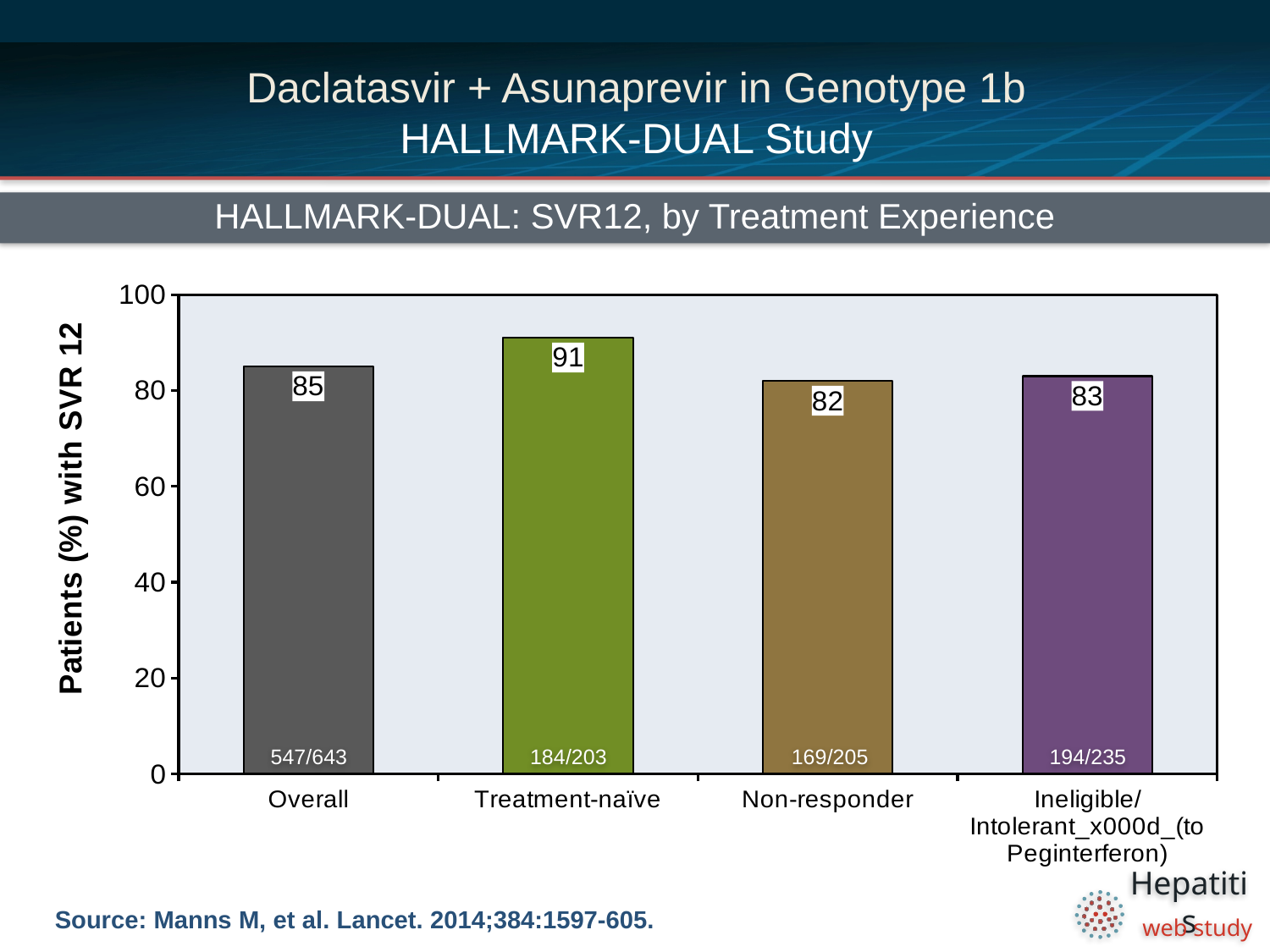
Which group has the lowest SVR12 rate? Non-responder Which has a higher SVR12 rate, Overall or Treatment-naïve? Treatment-naïve What is the SVR12 rate (%) for the Non-responder group? 82 What fraction of patients is shown inside the Ineligible/Intolerant (to Peginterferon) bar? 194/235 What is the difference in SVR12 rate between the Treatment-naïve and Non-responder groups? 9 Which group has the highest SVR12 rate? Treatment-naïve What is the label of the y axis? Patients (%) with SVR 12 What kind of chart is shown on the slide? Bar chart What is the SVR12 rate (%) for the Overall group? 85 How many patient groups are shown on the x axis? 4 Is the SVR12 rate for the Non-responder group greater or less than 80? greater What is the SVR12 rate (%) for the Treatment-naïve group? 91